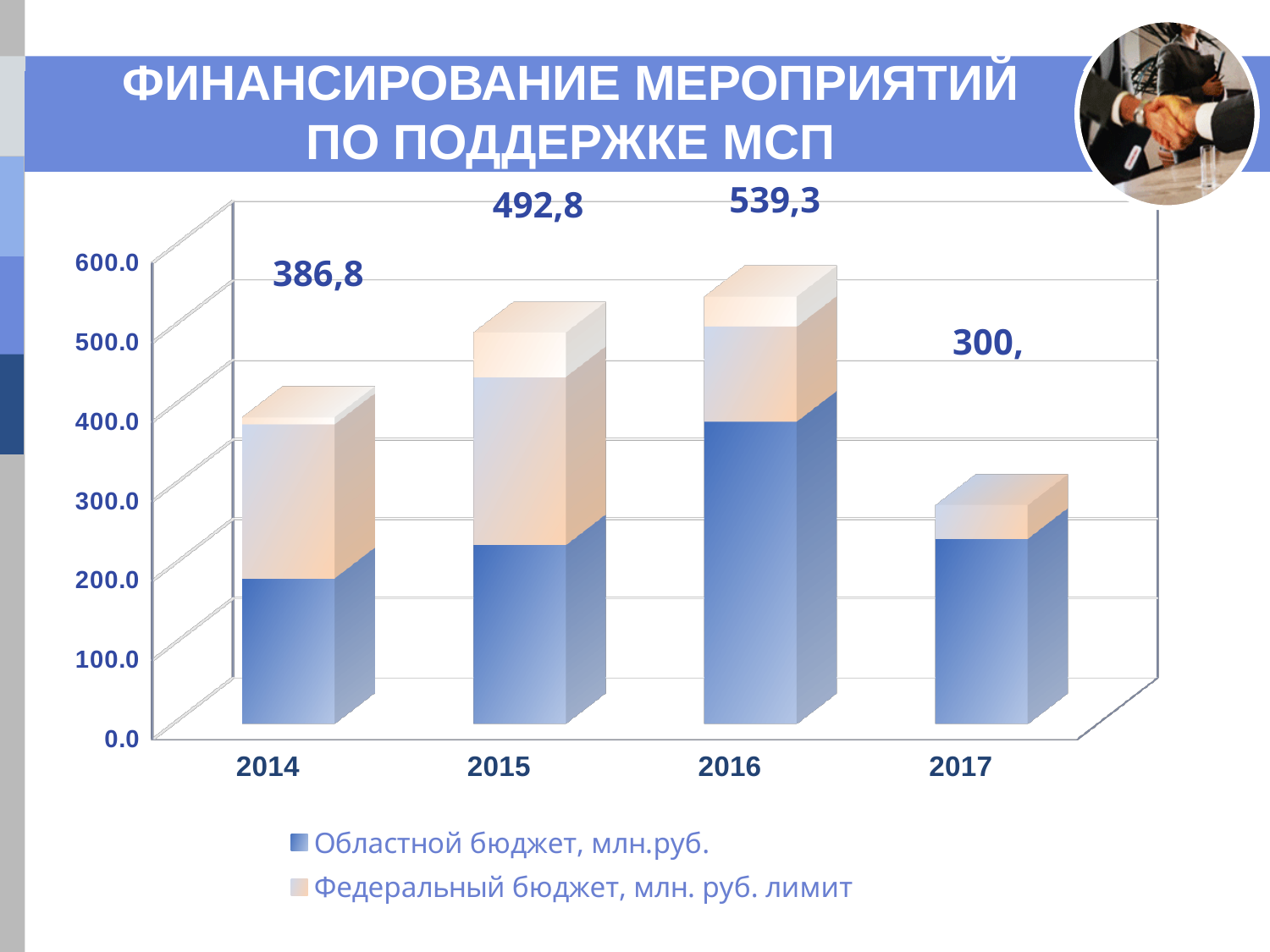
What is the difference between the total funding in 2016 and in 2014? 152,5 What is the total funding shown for 2016? 539,3 Is the value of Областной бюджет for 2016 greater or less than 300? greater Which year has the lowest total funding? 2017 Which year has the highest total funding? 2016 How many series does the legend list? 2 How many years are shown on the x axis? 4 What is the difference between the total funding in 2016 and in 2015? 46,5 Which is larger, the total funding in 2015 or in 2014? 2015 What is the total funding shown for 2014? 386,8 What is the total funding shown for 2015? 492,8 What kind of chart is shown on the slide? stacked bar chart